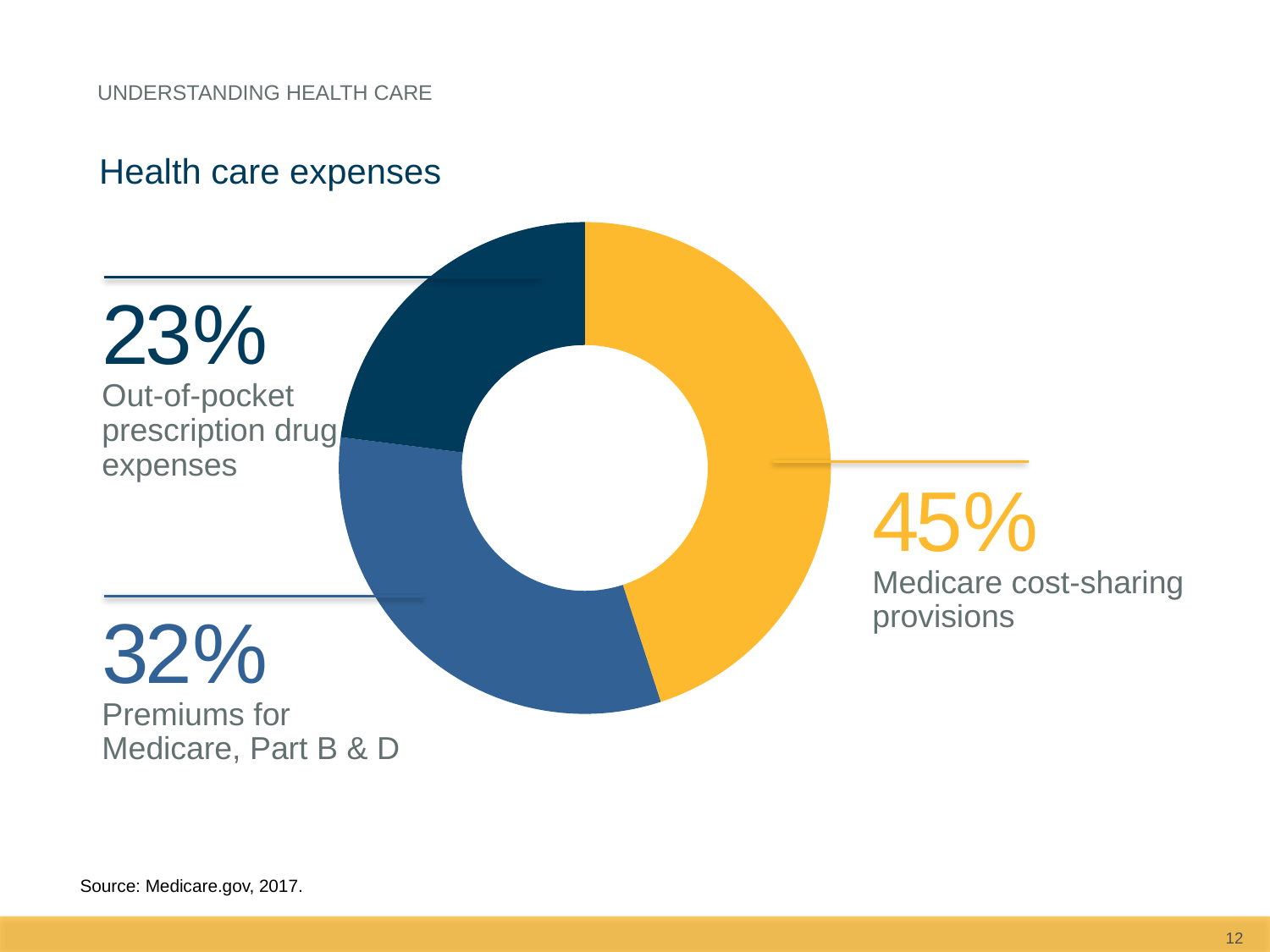
What is the difference in percentage points between Medicare cost-sharing provisions and premiums for Medicare, Part B & D? 13 percentage points What colour is the slice for Medicare cost-sharing provisions? Yellow What is the difference in percentage points between premiums for Medicare, Part B & D and out-of-pocket prescription drug expenses? 9 percentage points Which is larger: the share for premiums for Medicare, Part B & D or the share for out-of-pocket prescription drug expenses? Premiums for Medicare, Part B & D What share of health care expenses is attributed to Medicare cost-sharing provisions? 45% What share of health care expenses is out-of-pocket prescription drug expenses? 23% What share of health care expenses goes to premiums for Medicare, Part B & D? 32% How many categories are shown in the chart? 3 What is the title of the chart? Health care expenses Which category accounts for the smallest share of health care expenses? Out-of-pocket prescription drug expenses Which category accounts for the largest share of health care expenses? Medicare cost-sharing provisions What kind of chart is shown on the slide? Pie chart (donut)